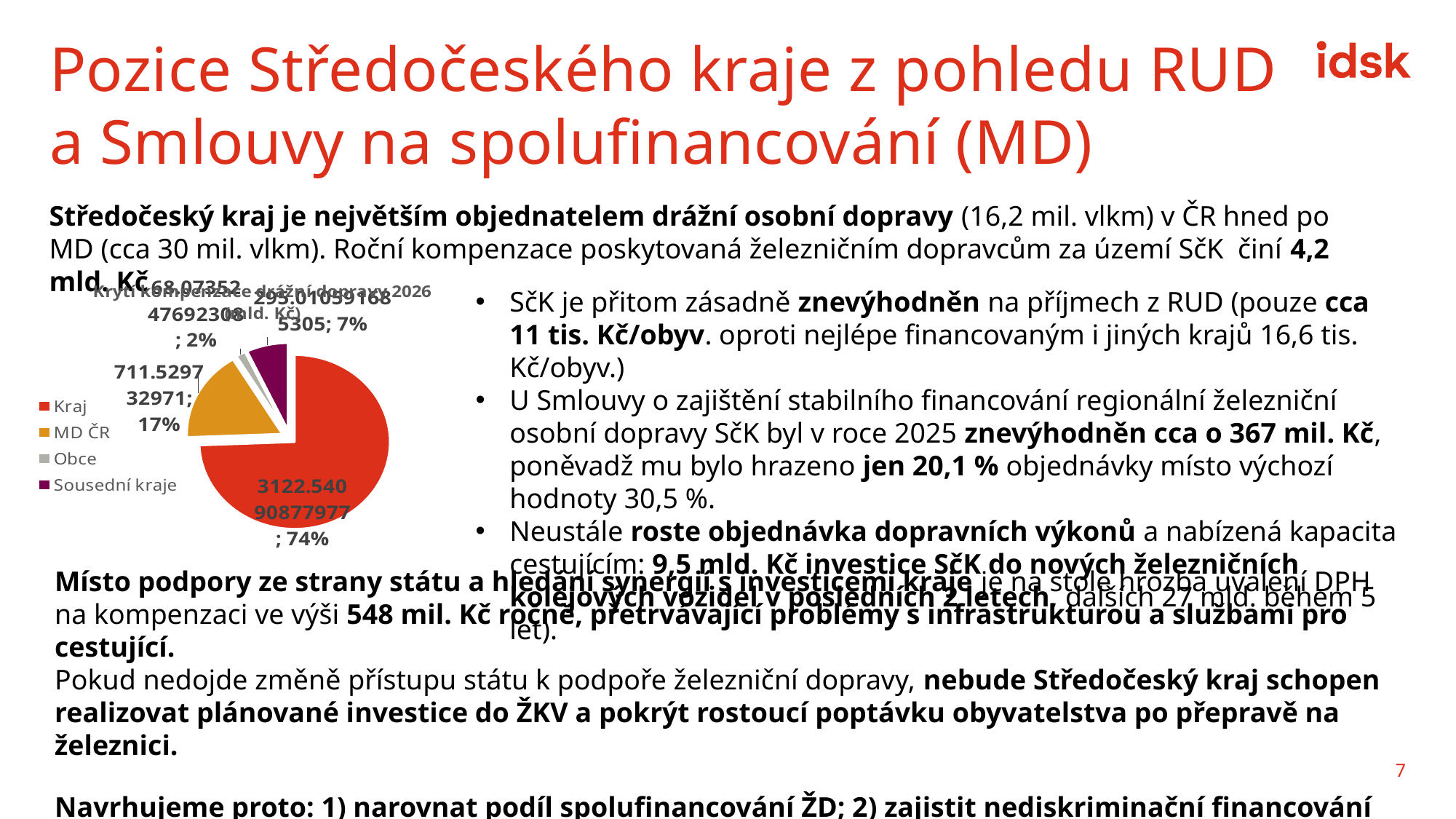
Which slice is larger, MD ČR or Sousední kraje? MD ČR Which category has the smallest slice of the pie chart? Obce What share of the pie does Sousední kraje account for? 7% Which category has the largest slice of the pie chart? Kraj Which legend entry is shown in red in the pie chart? Kraj What share of the pie does MD ČR account for? 17% What share of the pie does Kraj account for? 74% How many entries does the legend of the pie chart list? 4 What is the difference in percentage points between the Kraj share and the MD ČR share? 57 percentage points How many slices does the pie chart have? 4 What kind of chart is shown on the slide? pie chart